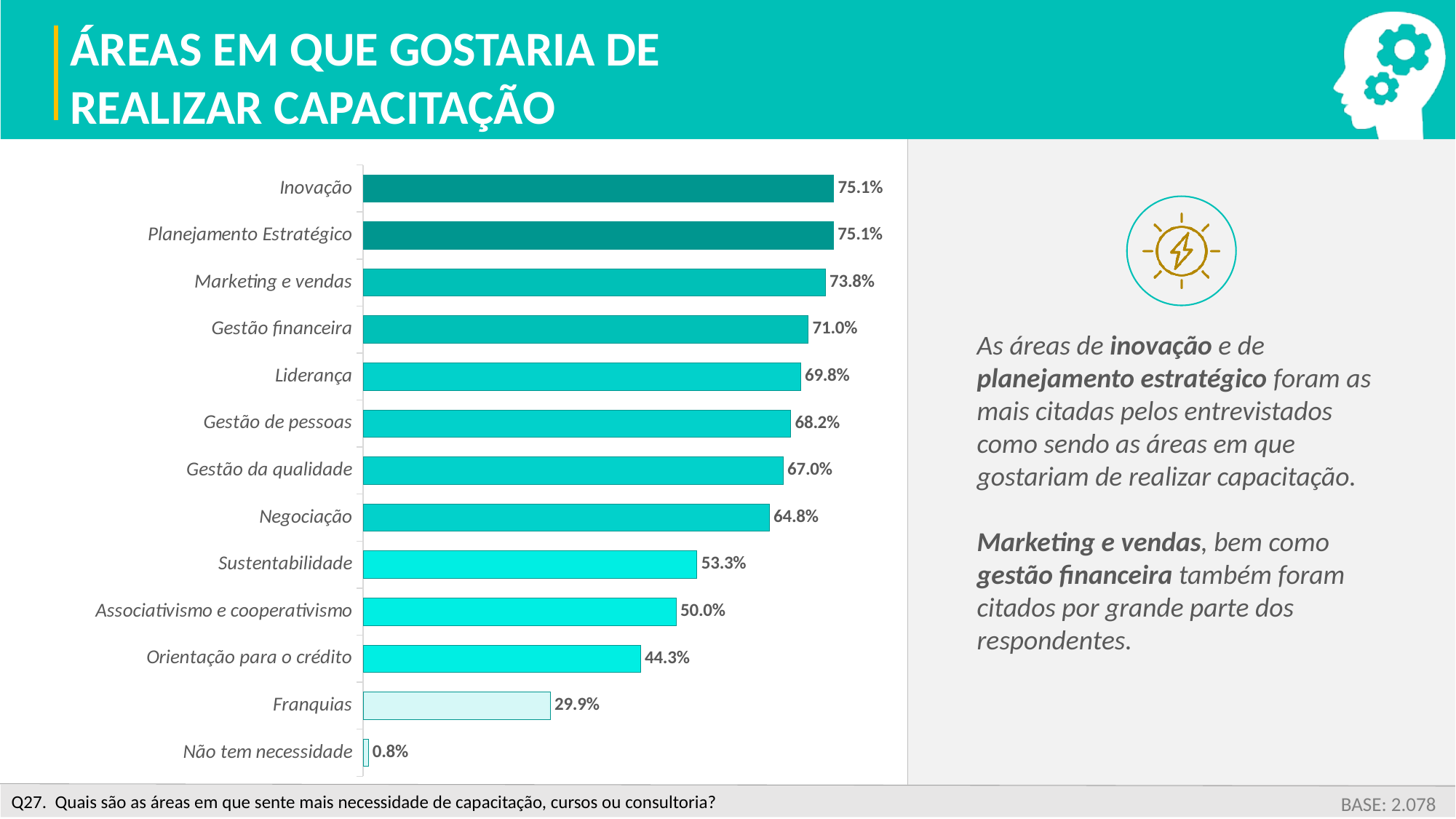
What is the difference between the values for Sustentabilidade and Associativismo e cooperativismo? 3.3% What is the value for Franquias? 29.9% Which category has the lowest value? Não tem necessidade Which is larger, the value for Liderança or the value for Gestão de pessoas? Liderança What is the value for Marketing e vendas? 73.8% What kind of chart is shown on the slide? Bar chart What is the difference between the values for Inovação and Negociação? 10.3% What is the value for Não tem necessidade? 0.8% How many categories are shown in the chart? 13 What is the value for Gestão financeira? 71.0% What is the value for Orientação para o crédito? 44.3% Which is larger, the value for Franquias or the value for Orientação para o crédito? Orientação para o crédito